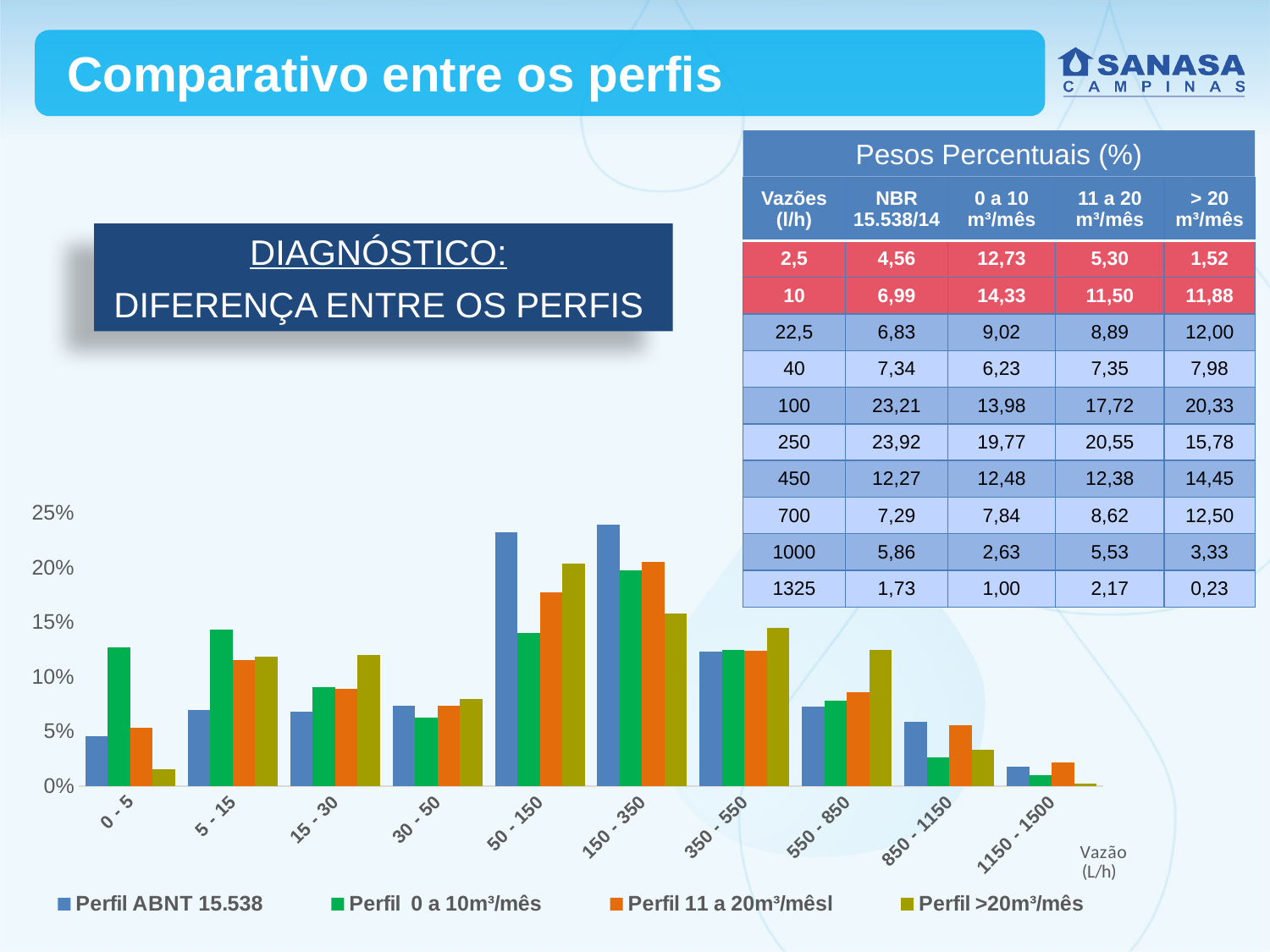
Is the value for Perfil 0 a 10m³/mês in the 0 - 5 category greater or less than 10%? greater How many series does the chart legend list? 4 In the 550 - 850 category, which is larger: Perfil ABNT 15.538 or Perfil >20m³/mês? Perfil >20m³/mês What label is shown on the x axis of the chart? Vazão (L/h) In the 0 - 5 category, which is larger: Perfil ABNT 15.538 or Perfil 0 a 10m³/mês? Perfil 0 a 10m³/mês Is the value for Perfil ABNT 15.538 in the 150 - 350 category greater or less than 20%? greater How many flow-rate categories are shown on the x axis of the chart? 10 Which series has the tallest bar anywhere in the chart? Perfil ABNT 15.538 In which category does Perfil >20m³/mês have its lowest value? 1150 - 1500 What kind of chart is shown on the slide? bar chart Is the value for Perfil 11 a 20m³/mêsl in the 1150 - 1500 category greater or less than 5%? less